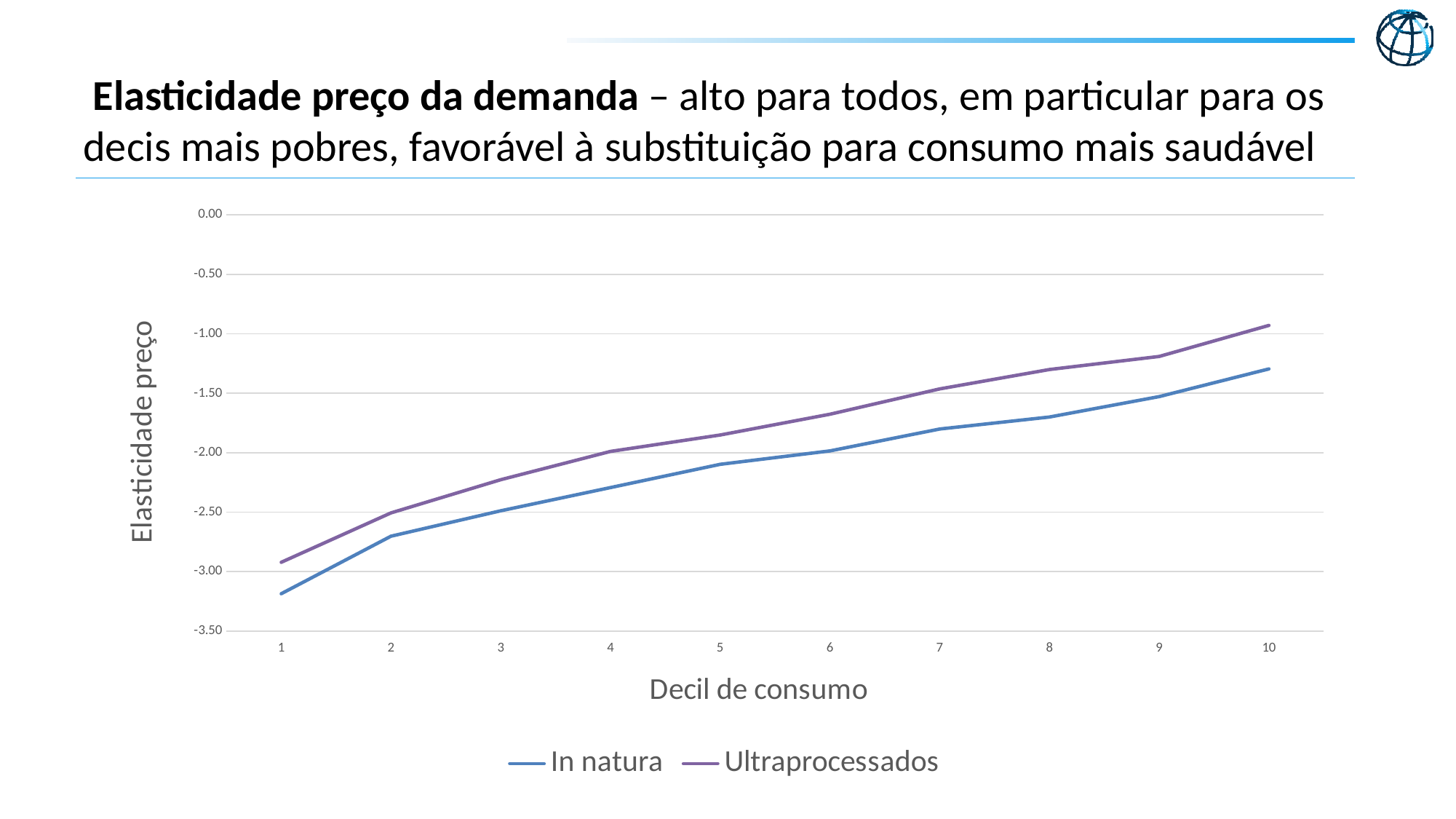
At which decile is the Ultraprocessados value highest? 10 Is the value for In natura at decile 1 greater or less than -3.00? less How many consumption deciles are plotted along the x axis? 10 Do the values for In natura rise or fall as the decile increases from 1 to 10? rise What is the title of the x axis of the chart? Decil de consumo Is the value for Ultraprocessados at decile 10 greater or less than -1.00? greater What kind of chart is shown on the slide? line chart How many series does the legend list? 2 At decile 1, which series has the higher (less negative) value, In natura or Ultraprocessados? Ultraprocessados Is the value for In natura at decile 10 greater or less than -1.00? less At which decile is the In natura value lowest? 1 Do the values for Ultraprocessados rise or fall as the decile increases from 1 to 10? rise